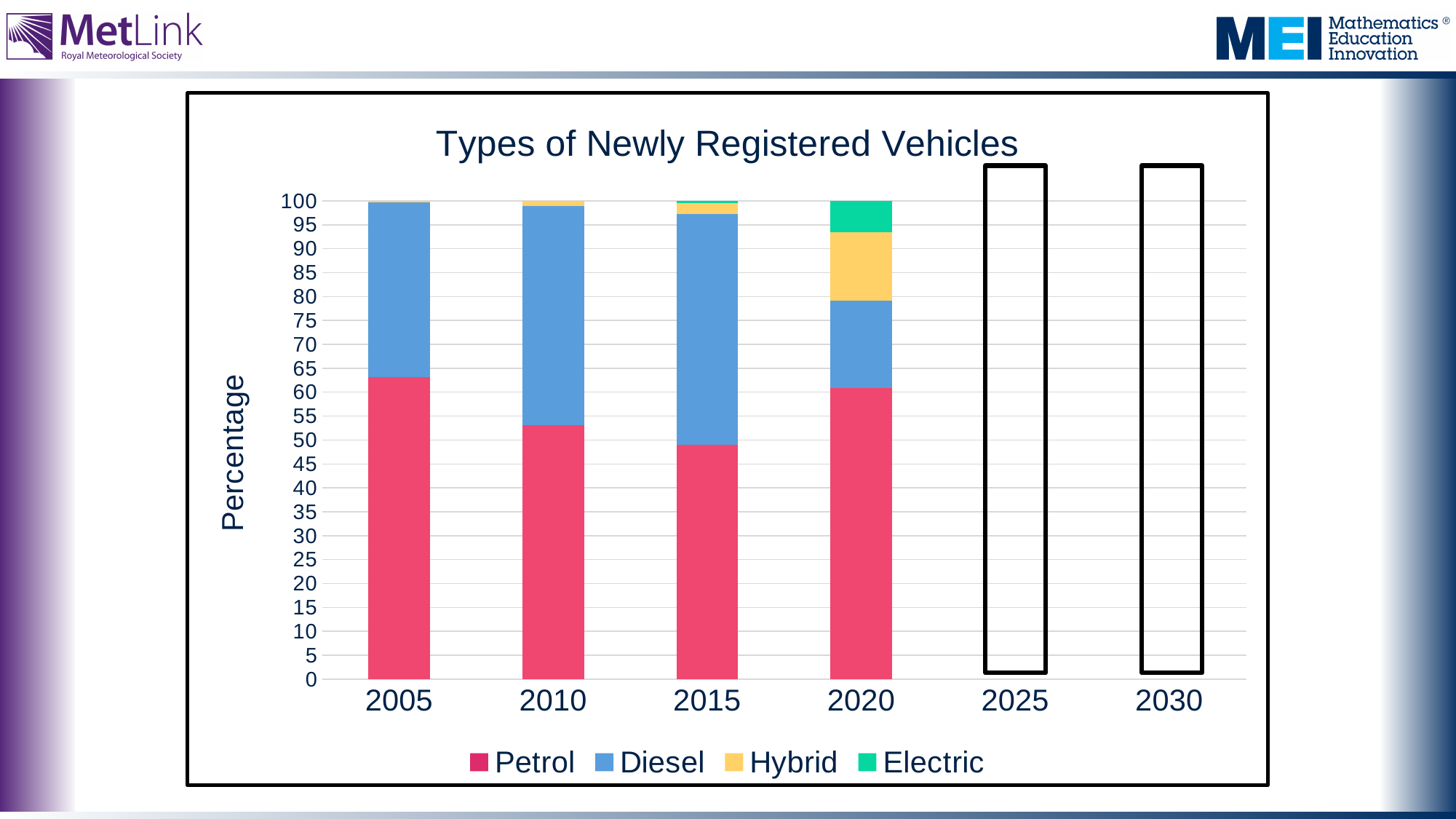
What kind of chart is shown on the slide? Stacked bar chart Which year has the largest Electric share? 2020 How many years on the x axis have plotted data bars? 4 Is the Hybrid share in 2020 greater or less than 10? greater Is the Petrol share in 2010 greater or less than 50? greater Is the Petrol share in 2005 greater or less than 60? greater Does the Petrol share rise or fall from 2005 to 2015? fall Which year has the largest Petrol share? 2005 What is the title of the chart? Types of Newly Registered Vehicles Which year has the smallest Petrol share? 2015 How many series does the legend list? 4